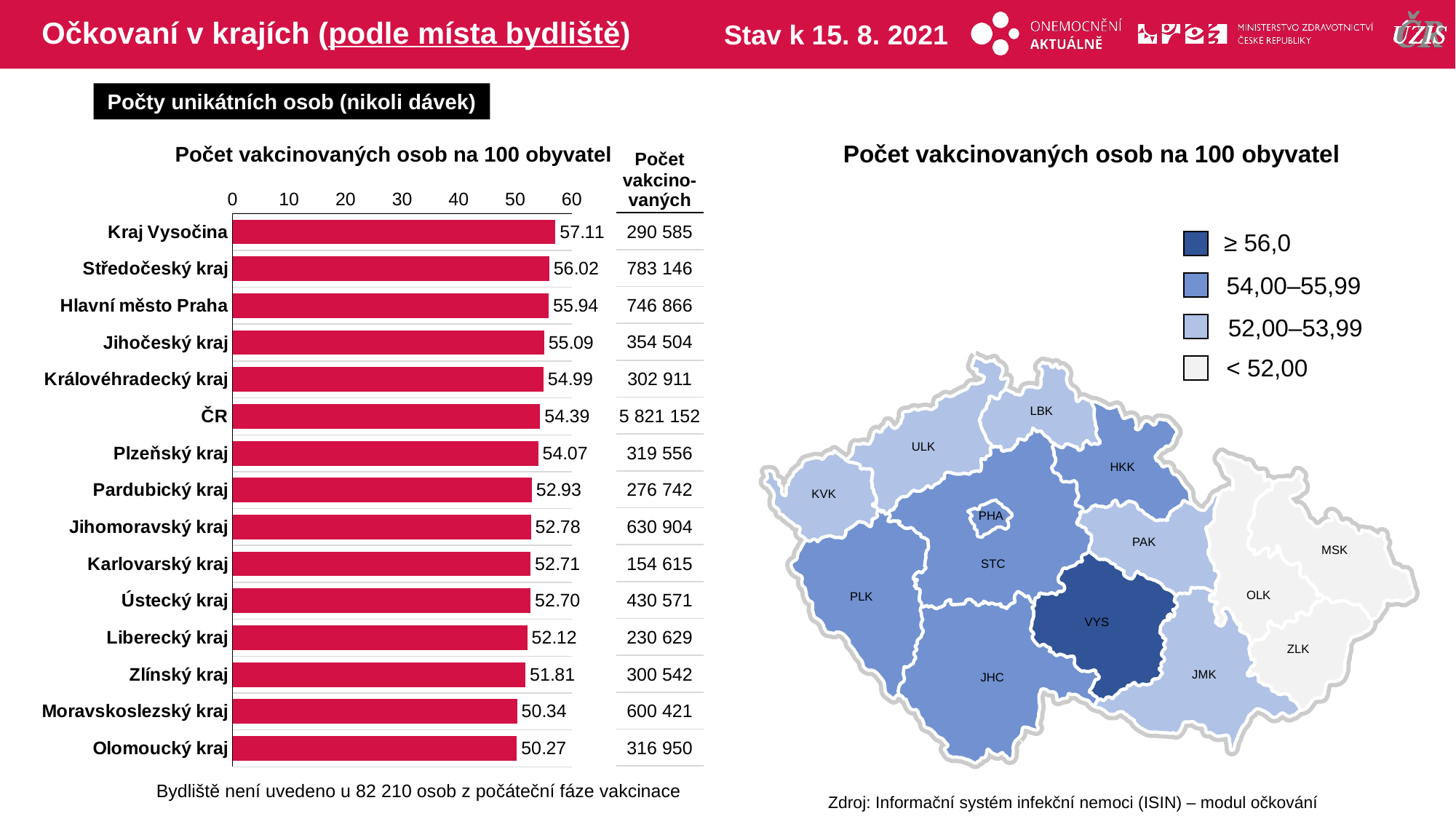
On the map 'Počet vakcinovaných osob na 100 obyvatel', what range does the darkest blue colour represent? ≥ 56,0 In the bar chart 'Počet vakcinovaných osob na 100 obyvatel', which is larger: Středočeský kraj or Hlavní město Praha? Středočeský kraj In the bar chart 'Počet vakcinovaných osob na 100 obyvatel', which region has the lowest value? Olomoucký kraj In the bar chart 'Počet vakcinovaných osob na 100 obyvatel', what is the value for ČR? 54.39 In the bar chart 'Počet vakcinovaných osob na 100 obyvatel', what is the value for Olomoucký kraj? 50.27 What kind of chart is used on the left side of the slide to show 'Počet vakcinovaných osob na 100 obyvatel'? bar chart In the bar chart 'Počet vakcinovaných osob na 100 obyvatel', which region has the highest value? Kraj Vysočina In the bar chart 'Počet vakcinovaných osob na 100 obyvatel', what is the difference between Kraj Vysočina and Olomoucký kraj? 6.84 In the 'Počet vakcinovaných' column next to the bar chart, what is the number for Středočeský kraj? 783 146 In the bar chart 'Počet vakcinovaných osob na 100 obyvatel', what is the value for Kraj Vysočina? 57.11 How many bars are shown in the bar chart 'Počet vakcinovaných osob na 100 obyvatel'? 15 In the bar chart 'Počet vakcinovaných osob na 100 obyvatel', is the value for Zlínský kraj greater or less than 50? greater